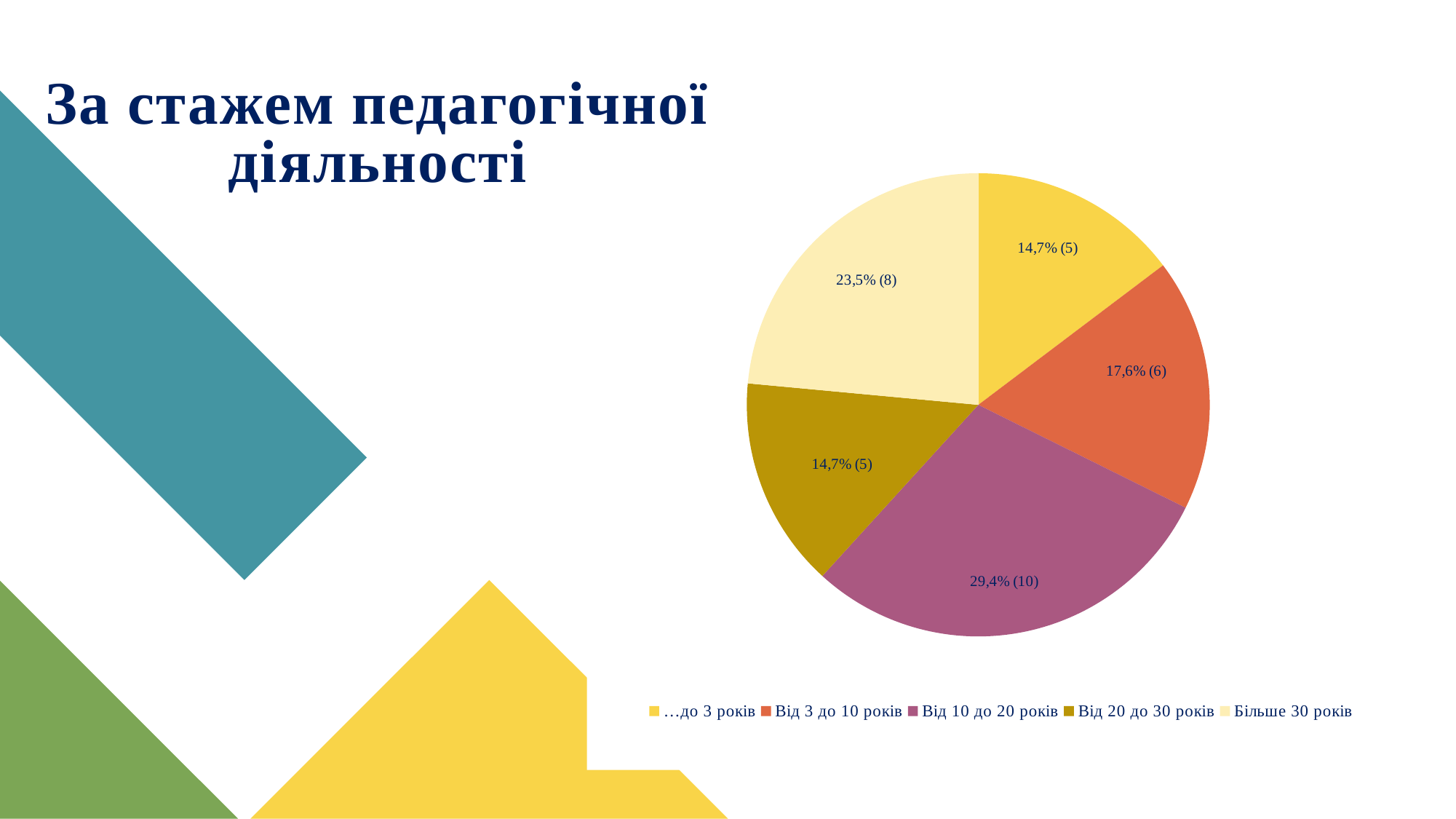
What kind of chart is shown on the slide? pie chart What is the data label for the "Від 10 до 20 років" slice? 29,4% (10) How many entries does the legend list? 5 What is the data label for the "Від 3 до 10 років" slice? 17,6% (6) What share of the pie does the "…до 3 років" slice represent? 14,7% Which legend entry is shown in purple? Від 10 до 20 років Which category has the largest slice of the pie? Від 10 до 20 років What is the title of the slide containing the pie chart? За стажем педагогічної діяльності Which is larger: the "Більше 30 років" slice or the "Від 3 до 10 років" slice? Більше 30 років What is the data label for the "Більше 30 років" slice? 23,5% (8) What is the difference in count between the "Від 10 до 20 років" slice (10) and the "Від 20 до 30 років" slice (5)? 5 How many slices does the pie chart have? 5